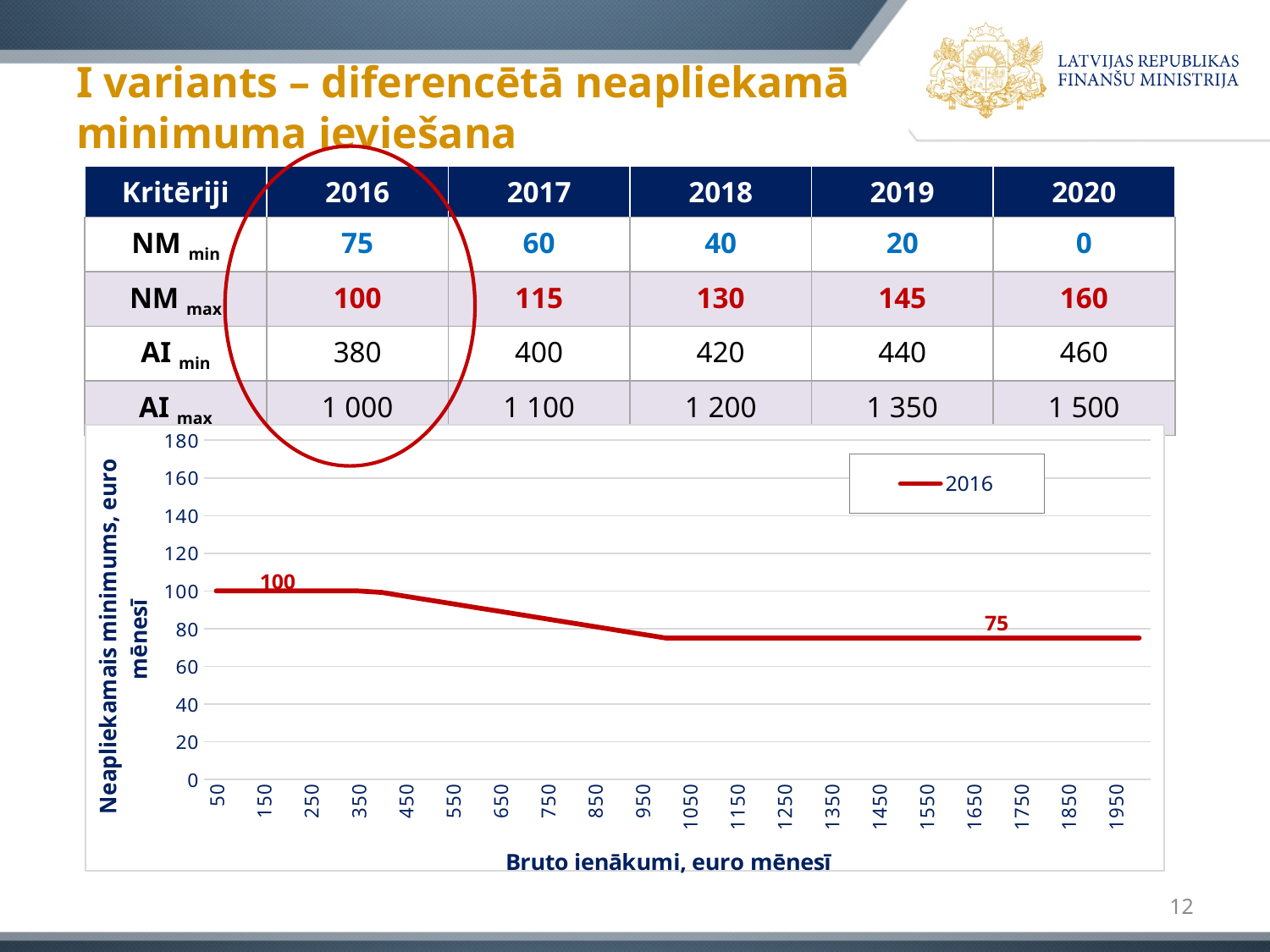
What is the data label shown on the line at the high-income end of the chart? 75 Is the value of the line at gross income 1250 greater or less than 100? less What kind of chart is shown on the slide? line chart Which is larger: the value of the line at gross income 150 or at gross income 1650? 150 How many series does the chart legend list? 1 Does the line rise or fall as gross income increases along the x axis? fall What is the data label shown on the line at the low-income end of the chart? 100 How many tick labels are shown on the x axis of the chart? 20 Is the value of the line at gross income 650 greater or less than 100? less What is the title of the chart's x axis? Bruto ienākumi, euro mēnesī What is the series name shown in the chart legend? 2016 What is the difference between the two labelled values on the line, 100 and 75? 25